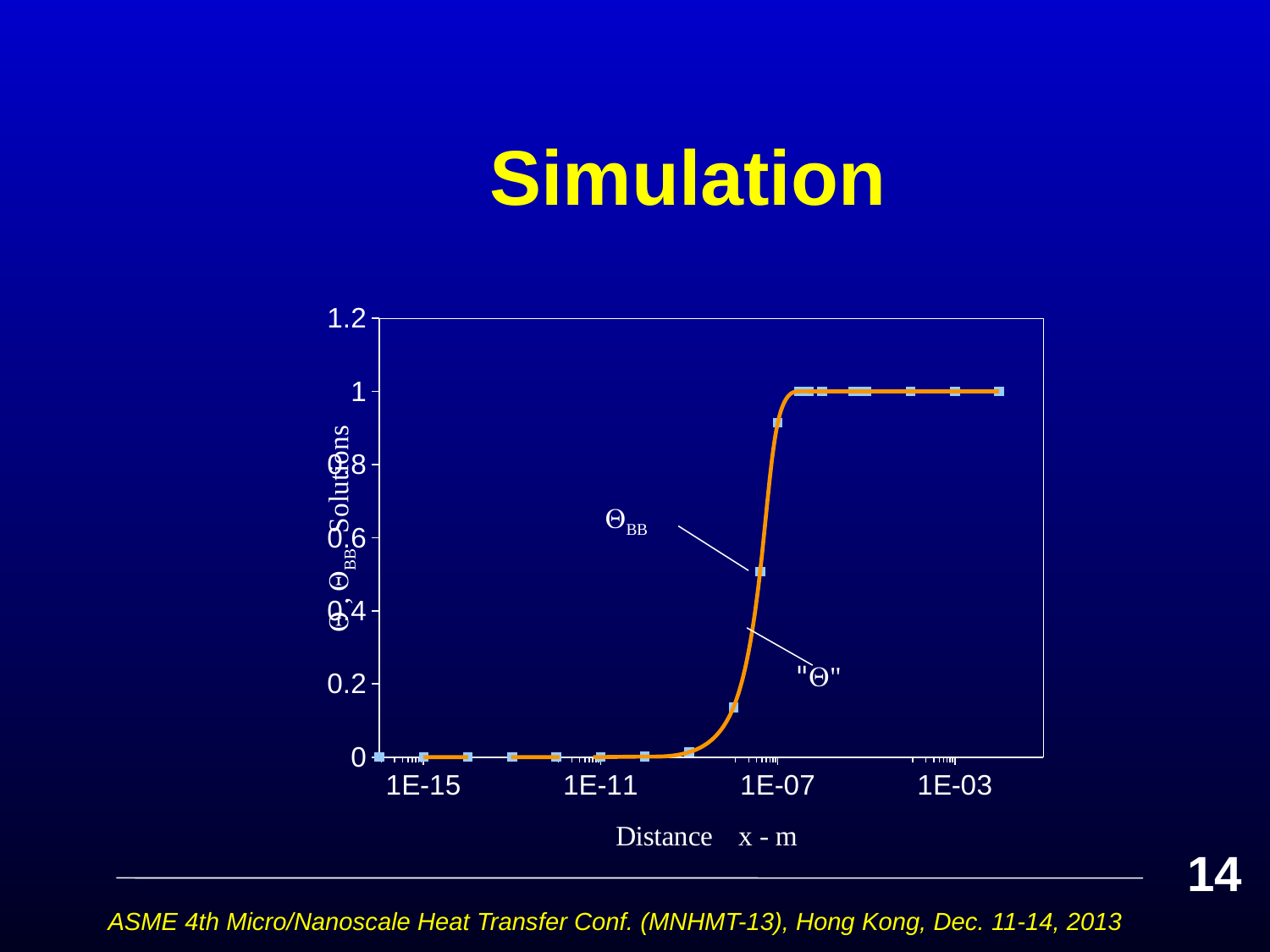
Which is larger, the plotted value at 1E-03 m or the plotted value at 1E-15 m? 1E-03 m What is the highest value shown on the y axis of the chart? 1.2 Is the plotted value at a distance of 1E-07 m greater or less than 0.2? greater How many curves are labelled by annotations on the chart? 2 Is the plotted value at a distance of 1E-03 m greater or less than 0.8? greater What is the label of the x axis of the chart? Distance x - m What kind of chart is shown on the slide? line chart Is the plotted value at a distance of 1E-15 m greater or less than 0.2? less Do the plotted values rise or fall as distance x increases along the x axis? rise